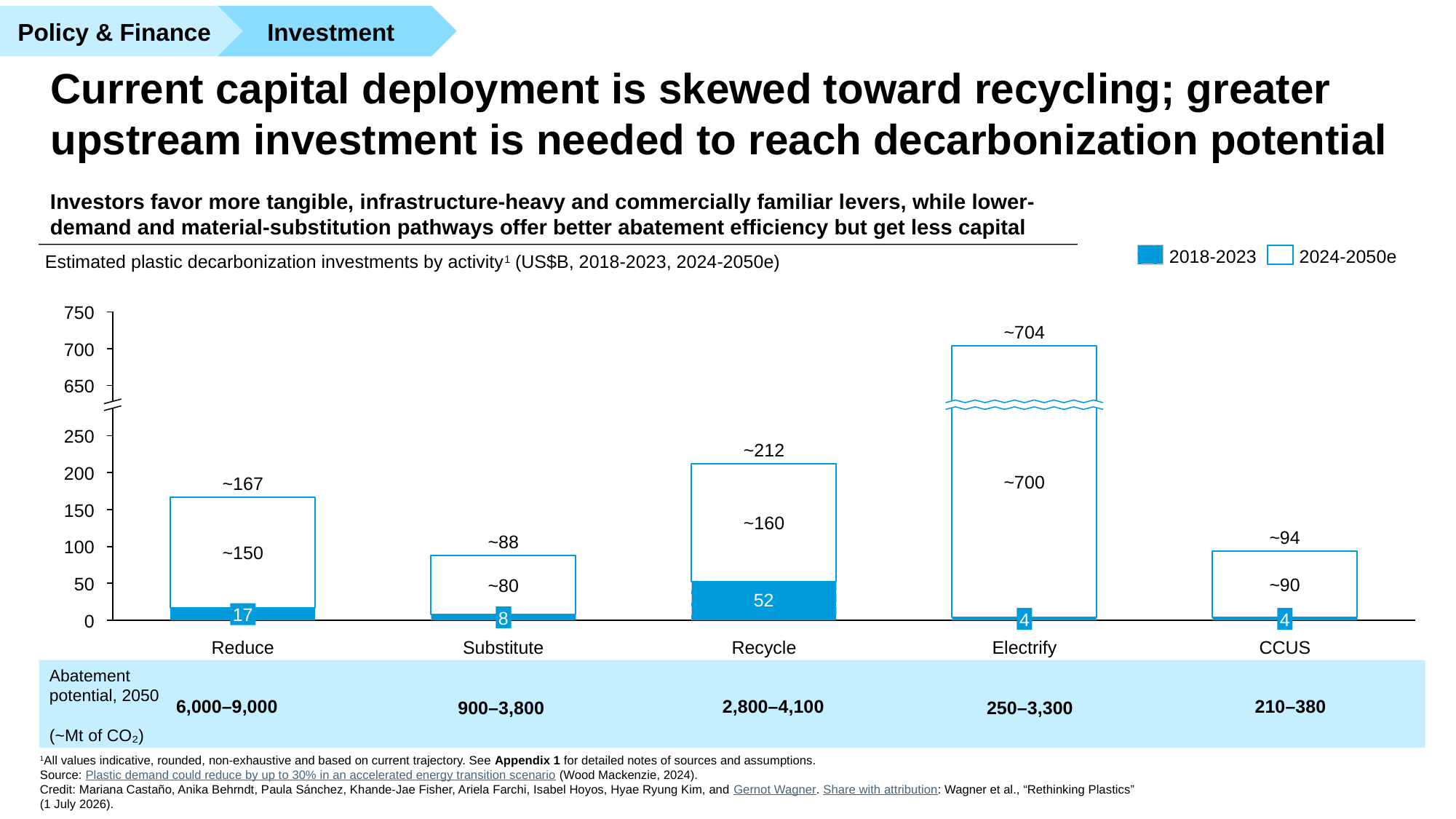
Which activity has the highest 2018-2023 investment? Recycle What abatement potential for 2050 is listed under Reduce? 6,000–9,000 What is the 2018-2023 investment value for Recycle? 52 What is the 2018-2023 investment value for Reduce? 17 Which has a larger 2018-2023 investment, Substitute or CCUS? Substitute What value is printed for the 2024-2050e segment of the Electrify bar? ~700 How many activity categories are shown on the x axis? 5 How many series does the legend list? 2 Which activity has the lowest total printed above its bar? Substitute What total value is printed above the Substitute bar? ~88 What kind of chart is shown on the slide? Stacked bar chart What is the difference between the 2018-2023 values for Recycle and Reduce? 35